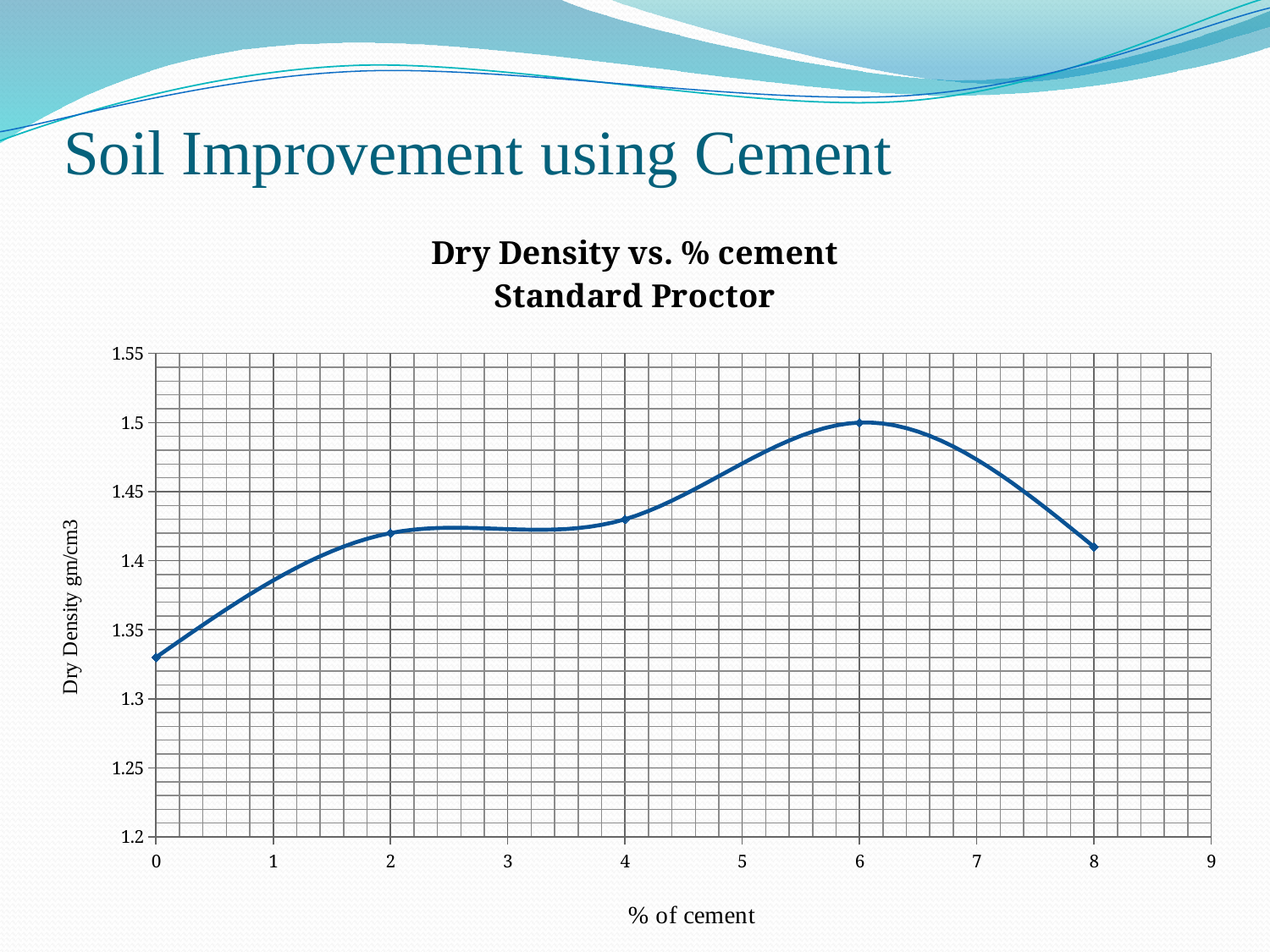
Is the dry density at 0% cement greater or less than 1.35? less What is the title of the chart? Dry Density vs. % cement Standard Proctor Is the dry density at 2% cement greater or less than 1.4? greater At which % of cement is the dry density lowest? 0 What is the dry density at 6% cement? 1.5 What type of chart is shown on the slide? line chart How many data points are plotted on the line? 5 Is the dry density at 8% cement greater or less than 1.45? less Which has the higher dry density, 6% cement or 8% cement? 6% cement What is the label of the vertical axis? Dry Density gm/cm3 Does the dry density rise or fall between 0% and 6% cement? rise At which % of cement is the dry density highest? 6